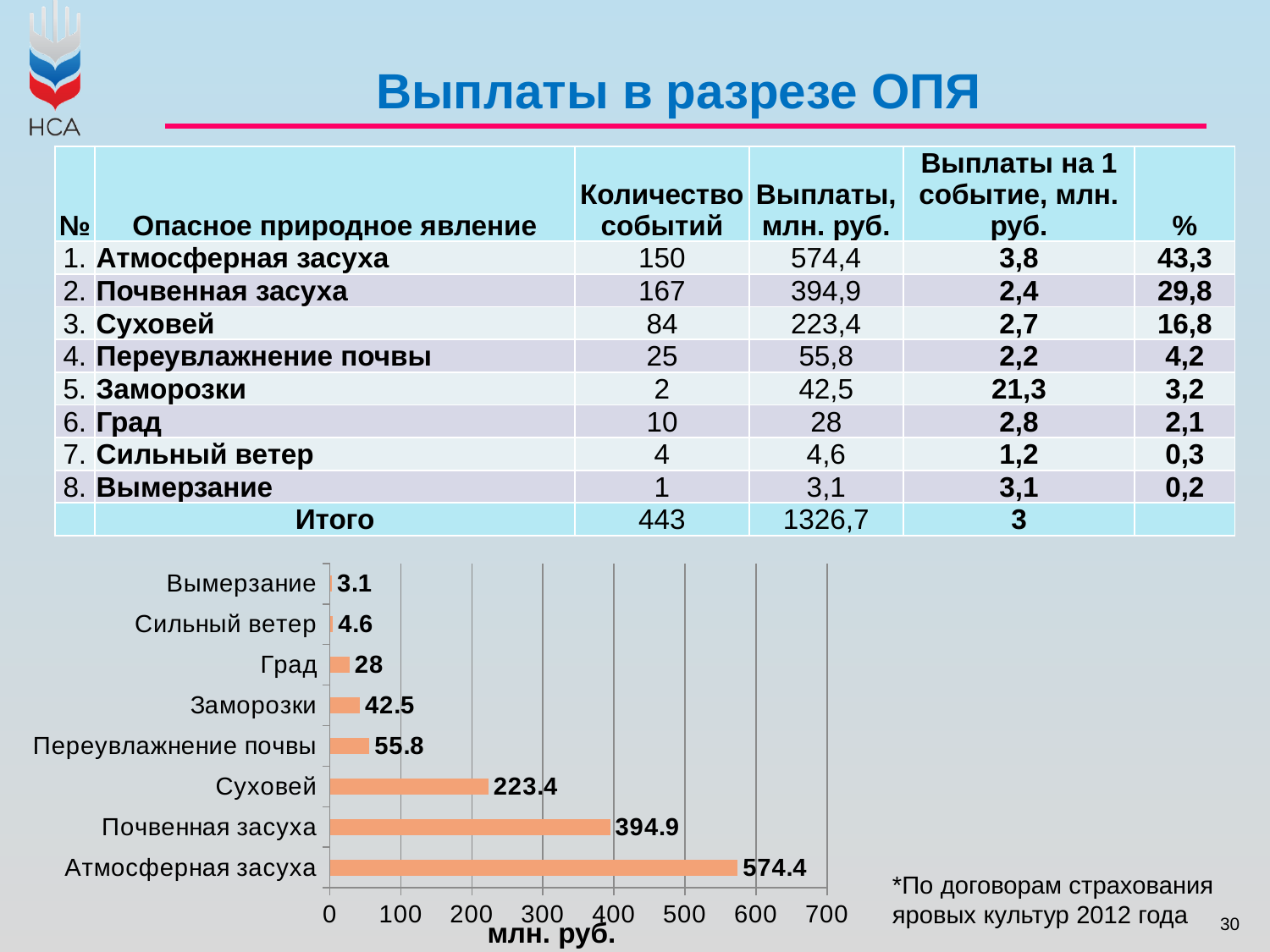
What is the value for Суховей in the bar chart? 223.4 How many categories are shown in the bar chart? 8 Is the value for Почвенная засуха in the bar chart greater or less than 300? greater What is the value for Атмосферная засуха in the bar chart? 574.4 What is the value for Град in the bar chart? 28 Which is larger in the bar chart: Заморозки or Переувлажнение почвы? Переувлажнение почвы What unit label is shown on the horizontal axis of the bar chart? млн. руб. What is the difference between the values for Атмосферная засуха and Почвенная засуха in the bar chart? 179.5 Which category has the lowest value in the bar chart? Вымерзание What is the difference between the values for Сильный ветер and Вымерзание in the bar chart? 1.5 What type of chart is shown on the slide? bar chart Which category has the highest value in the bar chart? Атмосферная засуха